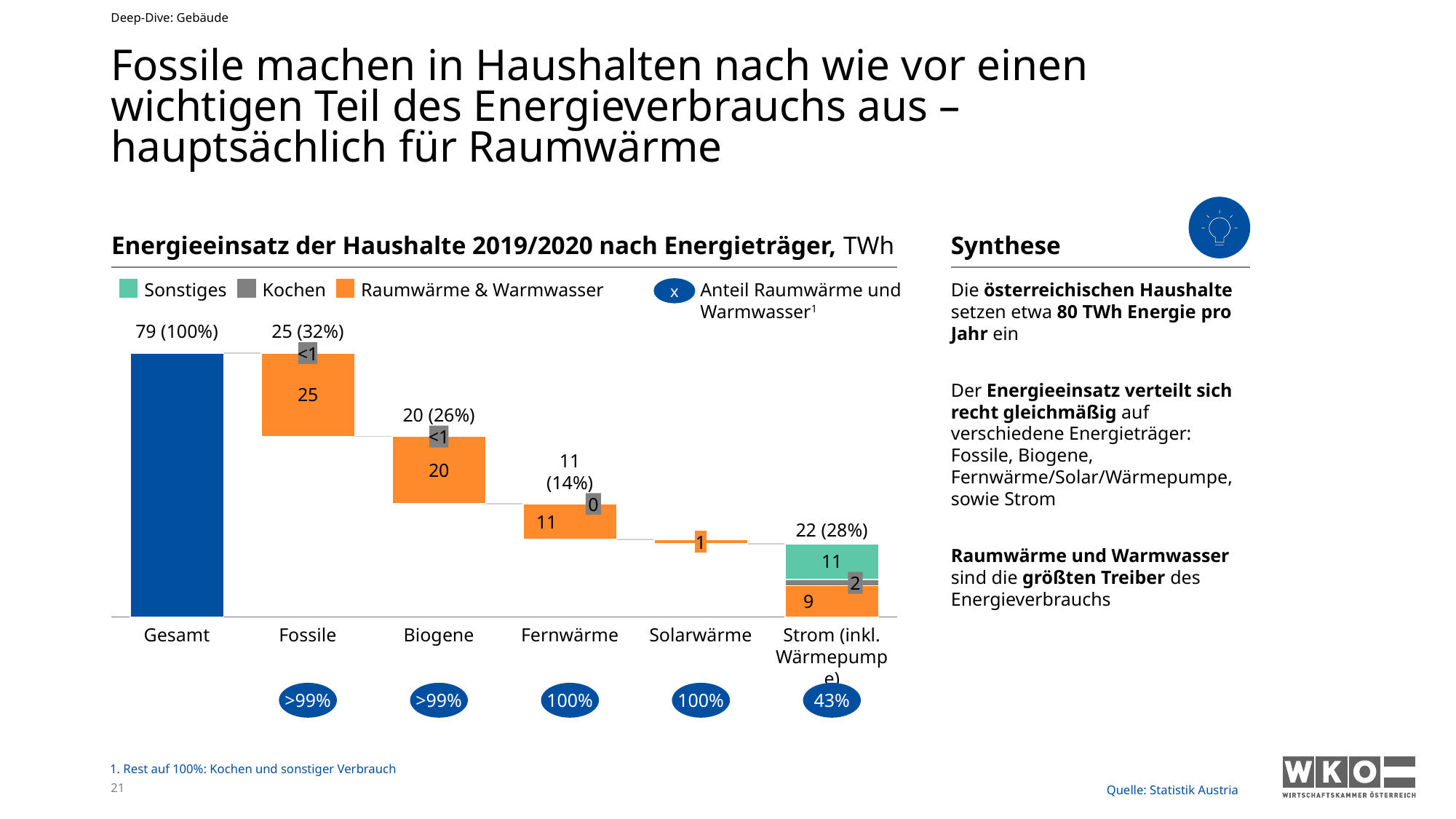
What is the Anteil Raumwärme und Warmwasser shown for Strom (inkl. Wärmepumpe)? 43% What is the difference between the totals for Fossile and Biogene? 5 Which energy carrier has the lowest value? Solarwärme What is the value of Raumwärme & Warmwasser for Strom (inkl. Wärmepumpe)? 9 What is the value of Sonstiges for Strom (inkl. Wärmepumpe)? 11 What share of the total (Gesamt) does Biogene account for? 26% How many series does the legend list? 3 Which energy carrier (excluding Gesamt) has the highest value? Fossile Which has a larger total, Biogene or Strom (inkl. Wärmepumpe)? Strom (inkl. Wärmepumpe) How many categories are shown on the x axis? 6 What is the total value shown for Fossile? 25 (32%) What is the total of the stacked bar for Strom (inkl. Wärmepumpe)? 22